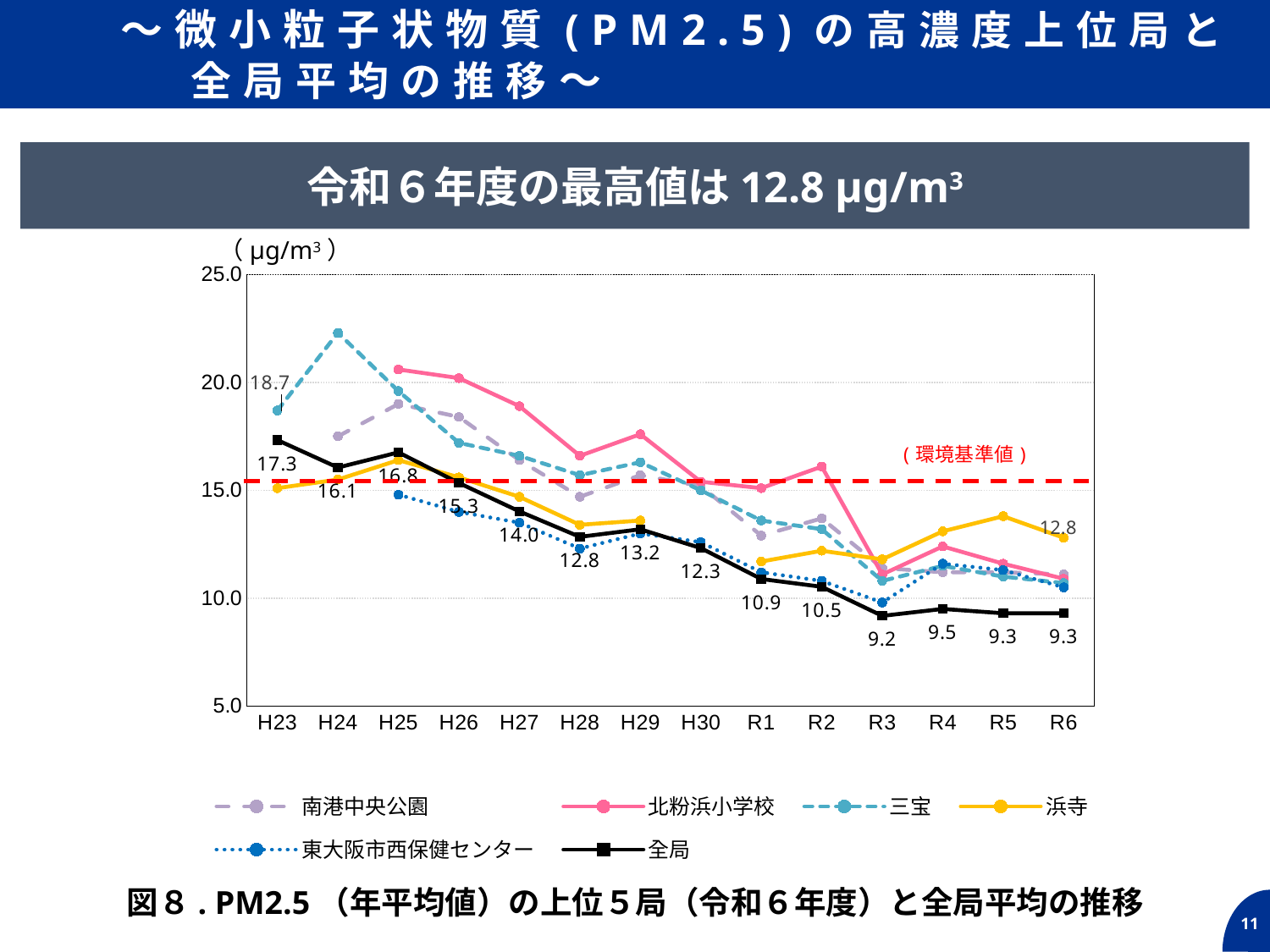
What is the value for 浜寺 at R6? 12.8 What is the value for 全局 at R3? 9.2 What kind of chart is shown? line chart Which year has the highest 全局 value? H23 What is the value for 全局 at H28? 12.8 What is the value for 全局 at H23? 17.3 What is the value for 全局 at R6? 9.3 What is the difference between the 全局 values at H23 and R6? 8.0 How many series does the legend list? 6 Is the value for 北粉浜小学校 at H25 greater or less than 20.0? greater Is the 全局 value at H24 larger or smaller than at H25? smaller Which year has the lowest 全局 value? R3